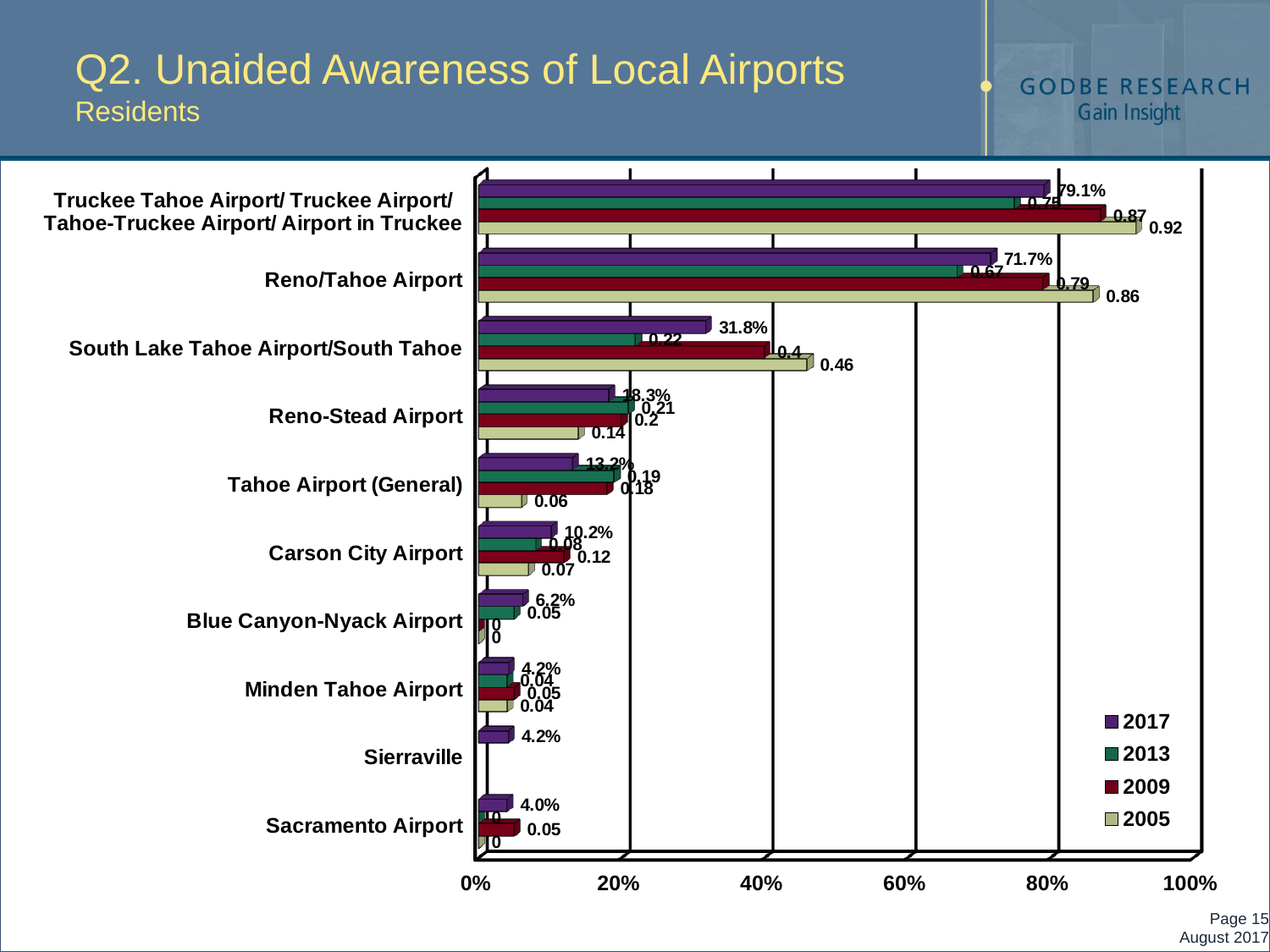
What is the 2005 value for South Lake Tahoe Airport/South Tahoe? 0.46 Which year is shown in purple in the legend? 2017 What kind of chart is shown on the slide? Bar chart What is the 2017 value for Reno/Tahoe Airport? 71.7% Which airport has the highest 2017 value? Truckee Tahoe Airport/ Truckee Airport/ Tahoe-Truckee Airport/ Airport in Truckee What is the 2017 value for Truckee Tahoe Airport/ Truckee Airport/ Tahoe-Truckee Airport/ Airport in Truckee? 79.1% What is the 2005 value for Truckee Tahoe Airport/ Truckee Airport/ Tahoe-Truckee Airport/ Airport in Truckee? 0.92 How many airport categories are shown on the chart? 10 For 2017, which is larger: Reno/Tahoe Airport or South Lake Tahoe Airport/South Tahoe? Reno/Tahoe Airport Is the 2013 value for Reno/Tahoe Airport greater or less than 60%? greater What is the difference between the 2017 values for Truckee Tahoe Airport and Reno/Tahoe Airport? 7.4 percentage points How many series does the legend list? 4